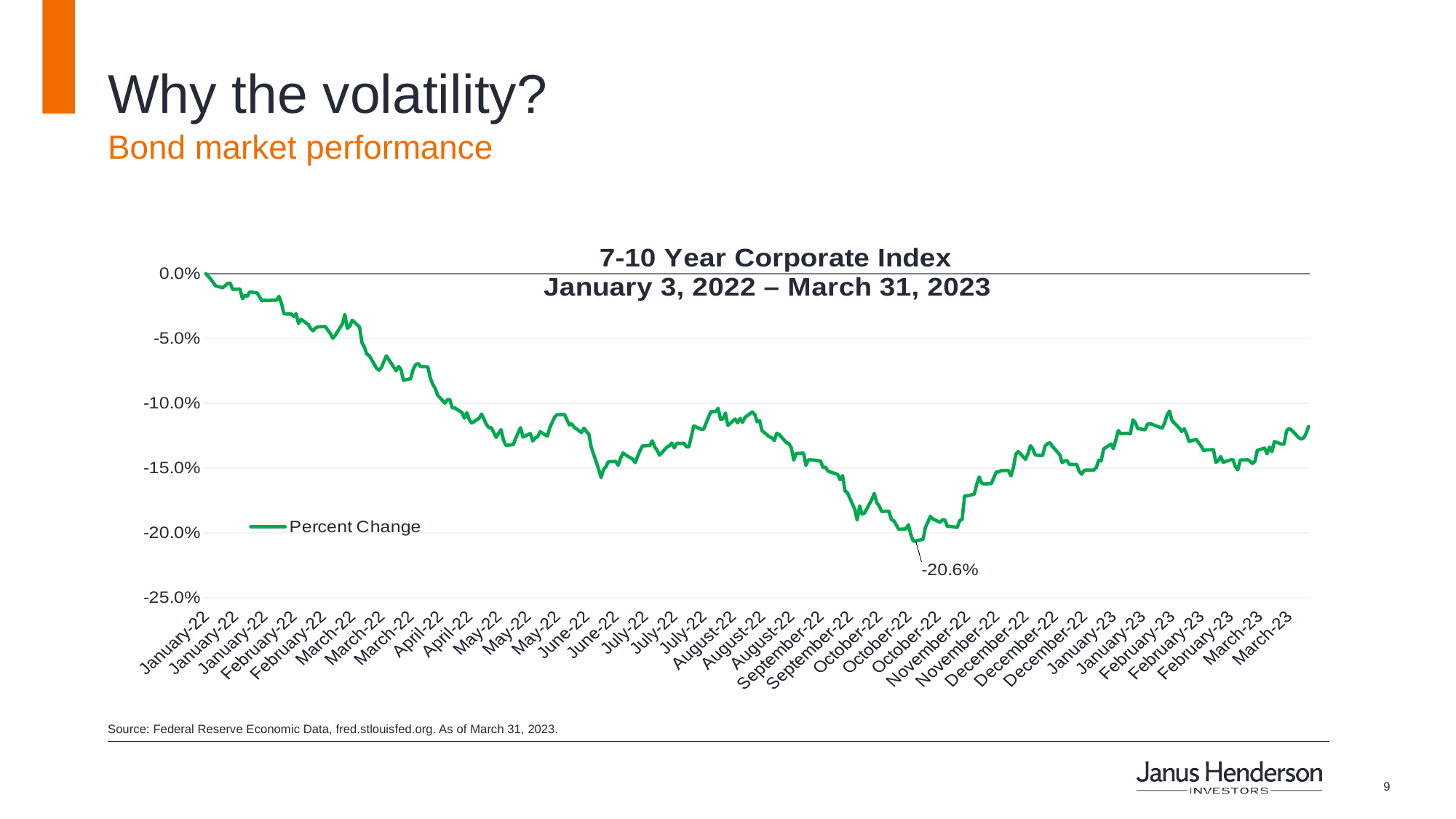
What is the lowest value labelled on the line? -20.6% Is the value in late May-22 greater or less than -15.0%? greater Does the line generally rise or fall from October-22 to March-23? rise Is the value in early January-22 larger or smaller than the value in October-22? larger What is the name of the series shown in the legend? Percent Change In which month does the line reach its lowest point of -20.6%? October-22 Does the line generally rise or fall from January-22 to October-22? fall Is the value at the end of March-23 greater or less than -15.0%? greater What kind of chart is shown on the slide? line chart What is the title of the chart? 7-10 Year Corporate Index January 3, 2022 – March 31, 2023 Is the lowest value on the line greater or less than -20.0%? less How many series does the chart's legend list? 1